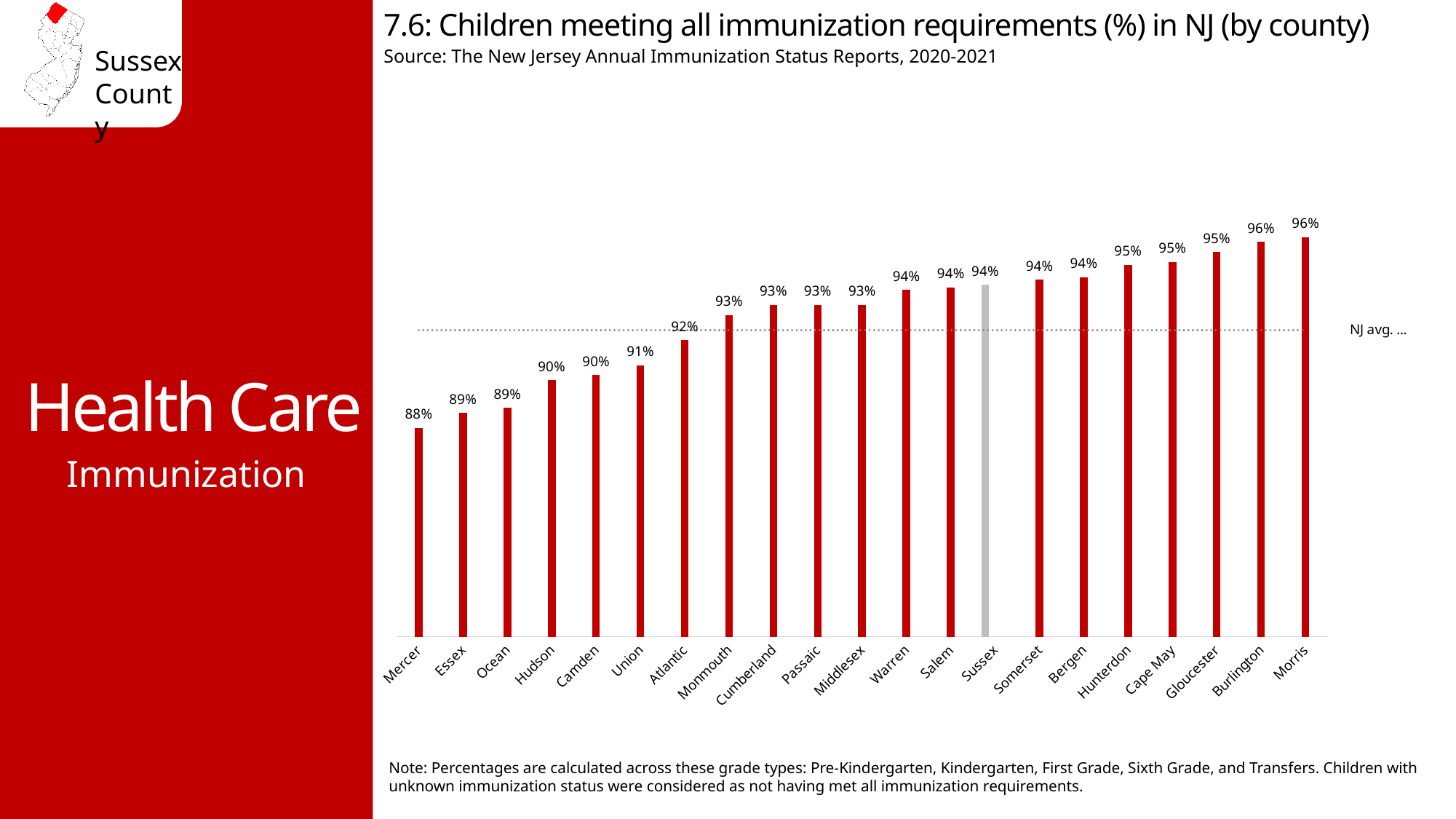
Which has a higher value, Sussex County or Union County? Sussex What is the difference in percentage points between Sussex County and Mercer County? 6 percentage points What percentage of children met all immunization requirements in Sussex County? 94% What is the value shown for Atlantic County? 92% What is the value shown for Hunterdon County? 95% How many counties are shown on the chart? 21 Which county's bar is coloured grey instead of red? Sussex What is the value shown for Mercer County? 88% Do the values rise or fall moving from left to right along the x axis? Rise What kind of chart is used on this slide? Bar chart Which county has the lowest percentage of children meeting all immunization requirements? Mercer What is the difference in percentage points between Morris County and Mercer County? 8 percentage points